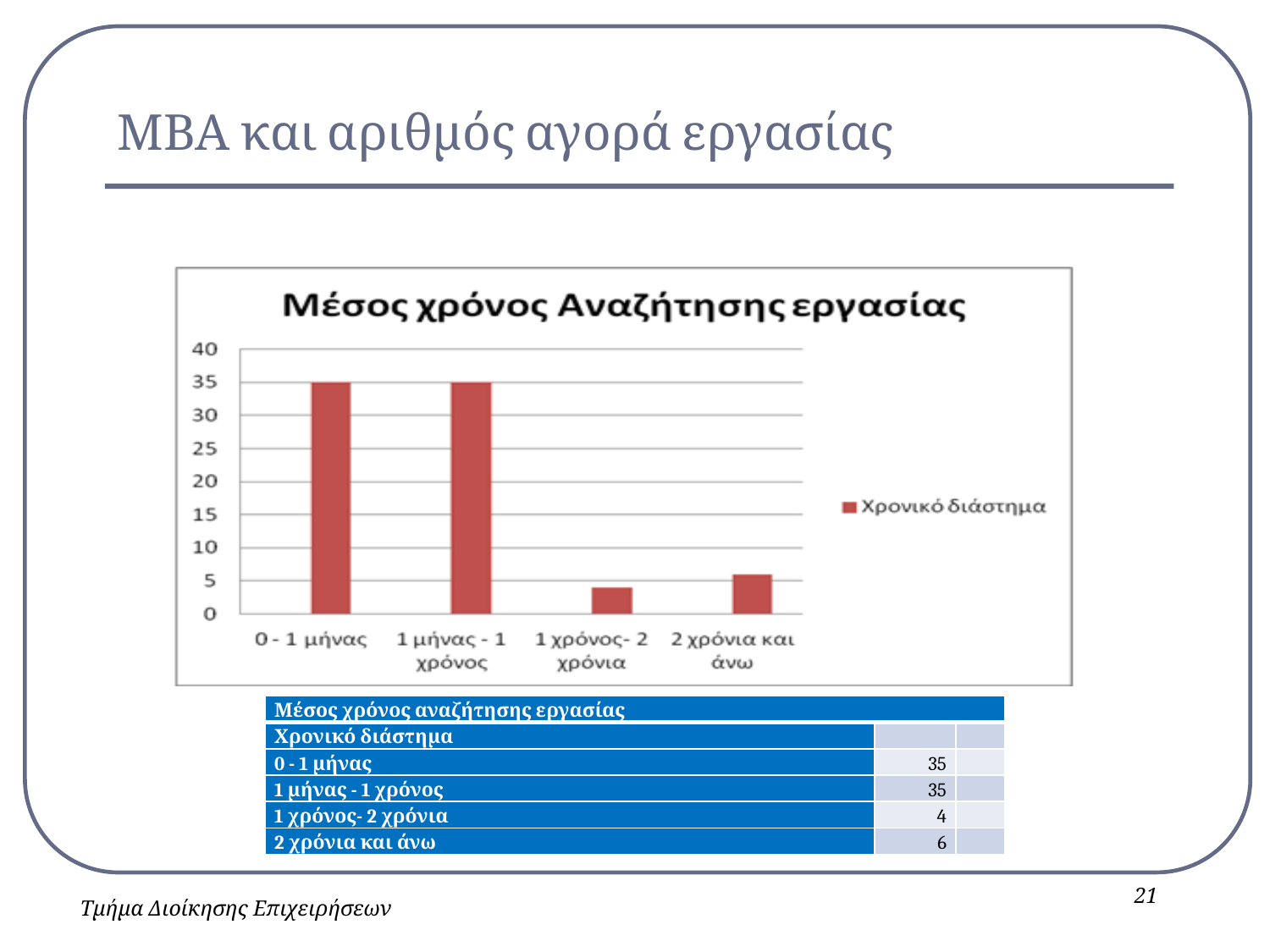
What is the name of the series shown in the legend? Χρονικό διάστημα What type of chart is shown on the slide? bar chart What is the value for the category '1 χρόνος- 2 χρόνια'? 4 What is the title of the chart? Μέσος χρόνος Αναζήτησης εργασίας What is the value for the category '0 - 1 μήνας'? 35 Which category has the lowest value? 1 χρόνος- 2 χρόνια What is the value for the category '1 μήνας - 1 χρόνος'? 35 Which is larger, the value for '2 χρόνια και άνω' or the value for '1 χρόνος- 2 χρόνια'? 2 χρόνια και άνω How many series does the chart legend list? 1 What is the value for the category '2 χρόνια και άνω'? 6 How many categories are shown on the x axis of the chart? 4 What is the difference between the values for '0 - 1 μήνας' and '2 χρόνια και άνω'? 29